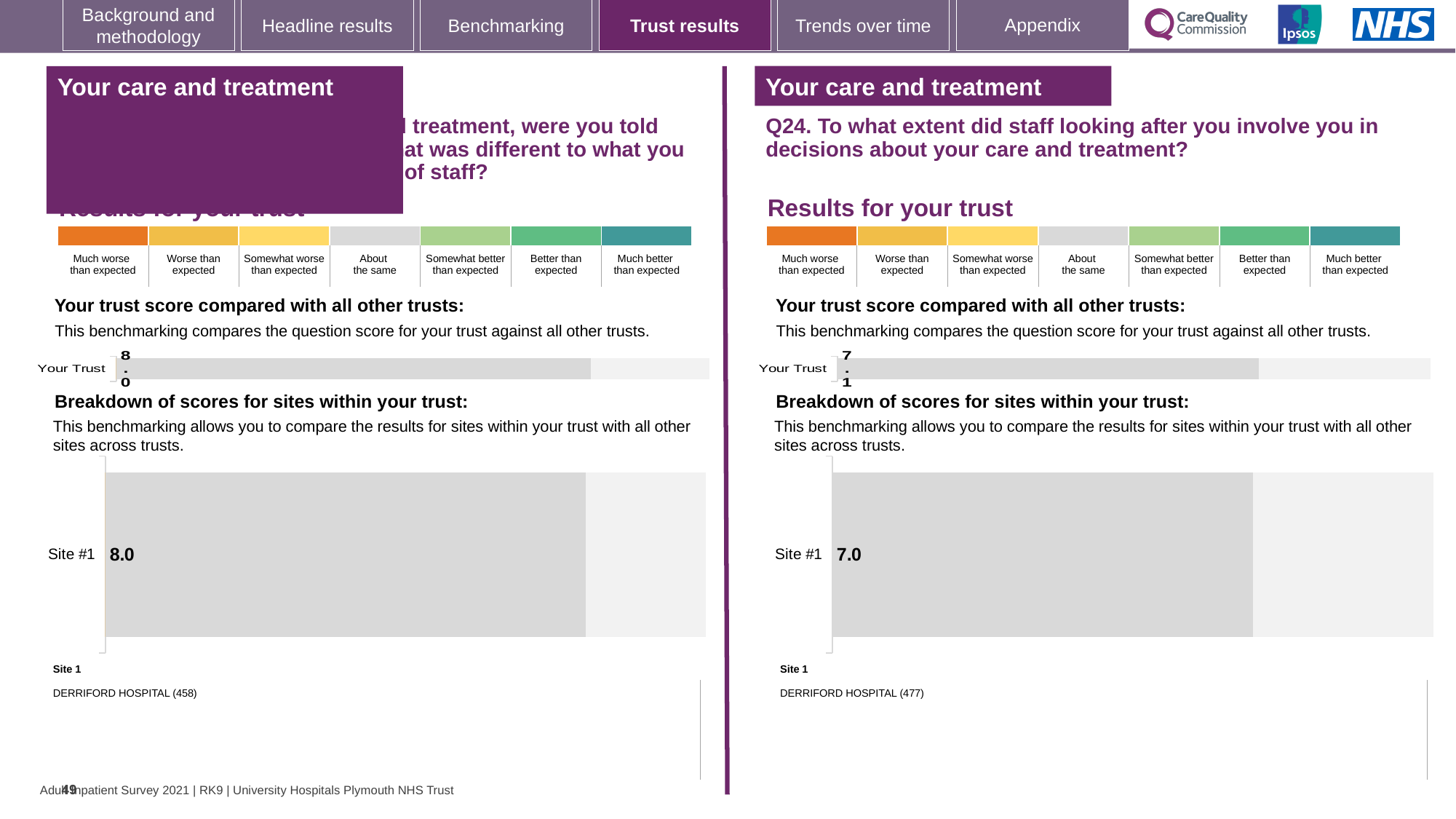
On the right-hand chart for Q24, what is the difference between the Your Trust score and the Site #1 score? 0.1 On the right-hand chart for Q24, what is the score shown for Your Trust? 7.1 On the right-hand chart for Q24, what is the score shown for Site #1? 7.0 Which is larger: the Site #1 score on the left-hand chart or the Site #1 score on the right-hand Q24 chart? Left-hand chart (8.0) On the left-hand chart, what is the score shown for Your Trust? 8.0 How many sites are shown in the breakdown of scores on the right-hand Q24 chart? 1 How many categories does the colour scale above the right-hand Q24 chart show, from 'Much worse than expected' to 'Much better than expected'? 7 What kind of chart is used to show the breakdown of scores for sites within your trust? Bar chart On the left-hand chart, what is the score shown for Site #1? 8.0 What is the difference between the Site #1 score on the left-hand chart and the Site #1 score on the right-hand Q24 chart? 1.0 On the right-hand Q24 chart, which hospital is listed as Site 1? DERRIFORD HOSPITAL